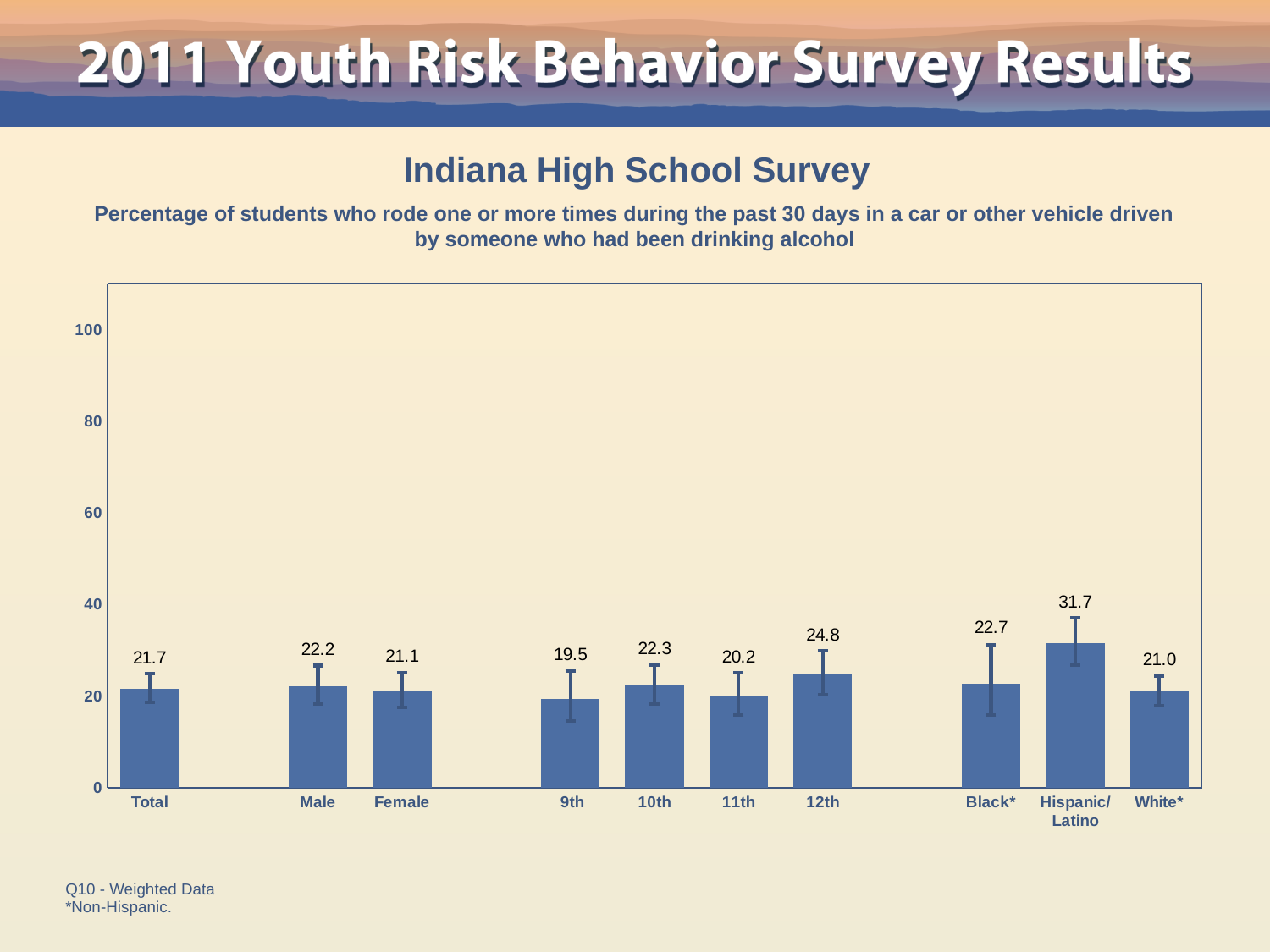
What is the value for 9th grade students? 19.5 Which is larger, the value for 12th grade or the value for 10th grade? 12th How many categories are shown on the x axis? 10 What is the difference between the values for Male and Female? 1.1 Which category has the lowest value? 9th What is the difference between the values for Hispanic/Latino and White*? 10.7 What kind of chart is shown on the slide? bar chart Is the value for Hispanic/Latino greater or less than 40? less What is the value for Total? 21.7 What is the value for Hispanic/Latino students? 31.7 Which category has the highest value? Hispanic/Latino